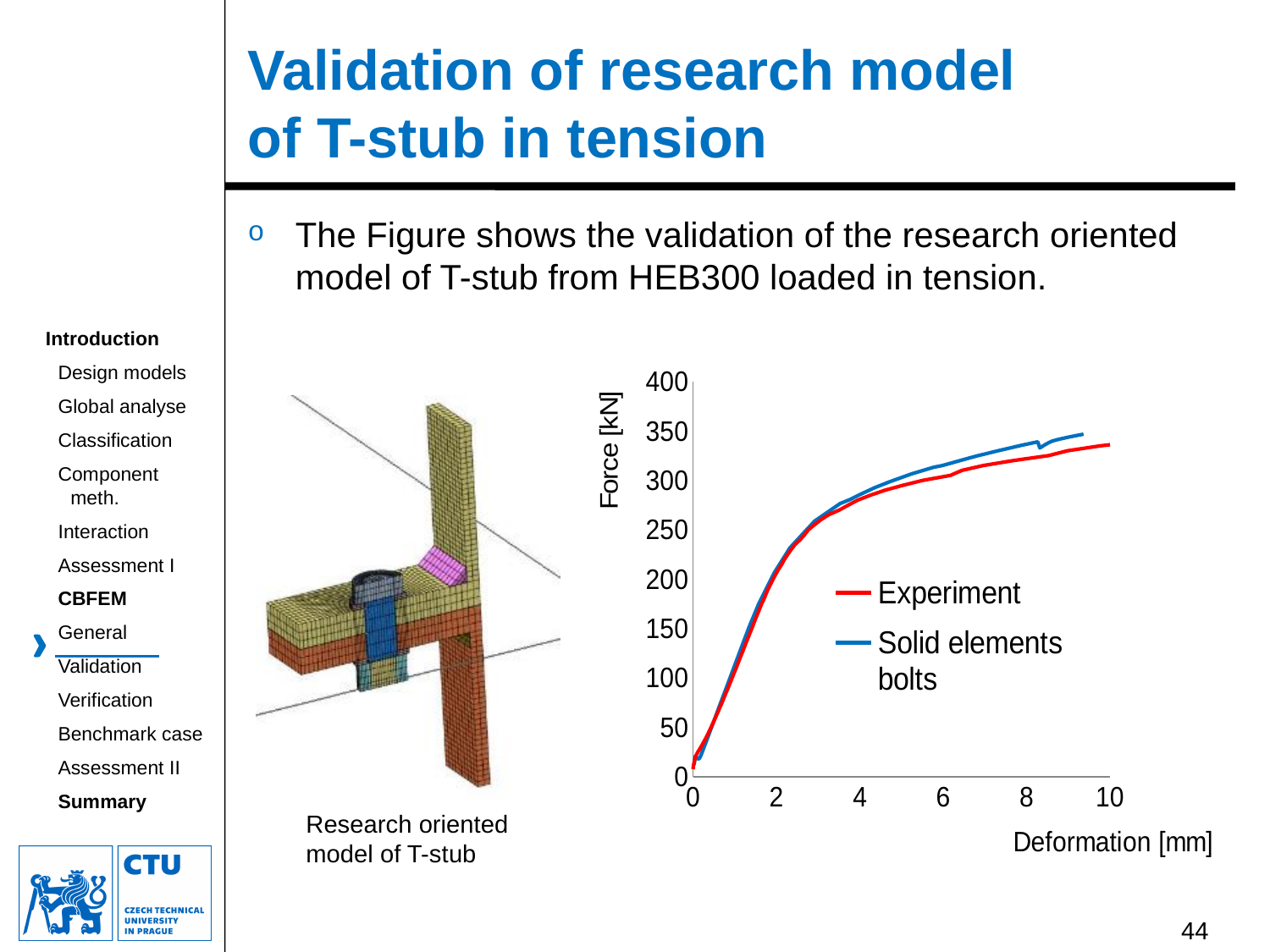
Which series reaches the higher maximum force, Experiment or Solid elements bolts? Solid elements bolts What is the label of the vertical axis of the chart? Force [kN] What is the highest tick value shown on the Deformation axis? 10 What colour is the Experiment line in the chart? red Is the force of the Experiment series at a deformation of 2 mm greater or less than 150 kN? greater Does the force in the Experiment series rise or fall as deformation increases? rise How many series does the chart legend list? 2 Is the force of the Experiment series at a deformation of 8 mm greater or less than 300 kN? greater What are the two series named in the chart legend? Experiment; Solid elements bolts What is the highest tick value shown on the Force axis? 400 What is the label of the horizontal axis of the chart? Deformation [mm] What kind of chart is shown on the slide? line chart